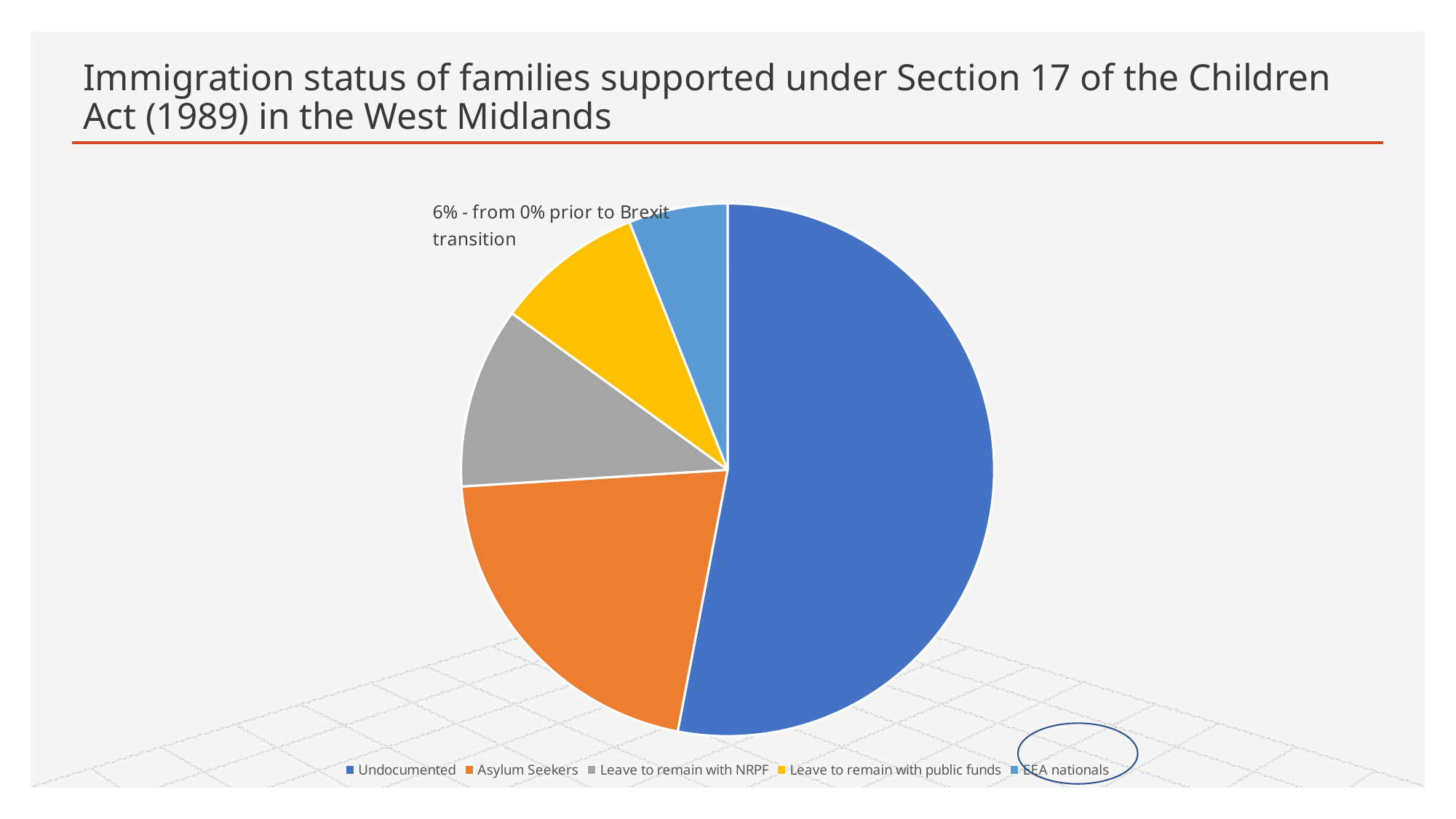
According to the annotation, what was the EEA nationals share prior to the Brexit transition? 0% Which immigration status category has the smallest slice of the pie? EEA nationals Which slice is larger: Leave to remain with public funds or EEA nationals? Leave to remain with public funds How many slices does the pie chart have? 5 Which immigration status category has the largest slice of the pie? Undocumented How many entries does the legend list? 5 Which slice is larger: Asylum Seekers or Leave to remain with NRPF? Asylum Seekers What colour is the Asylum Seekers slice? orange Which slice is larger: Undocumented or Asylum Seekers? Undocumented What kind of chart is shown on the slide? pie chart What share of the pie do EEA nationals account for, according to the annotation on the chart? 6% What is the title of the slide? Immigration status of families supported under Section 17 of the Children Act (1989) in the West Midlands